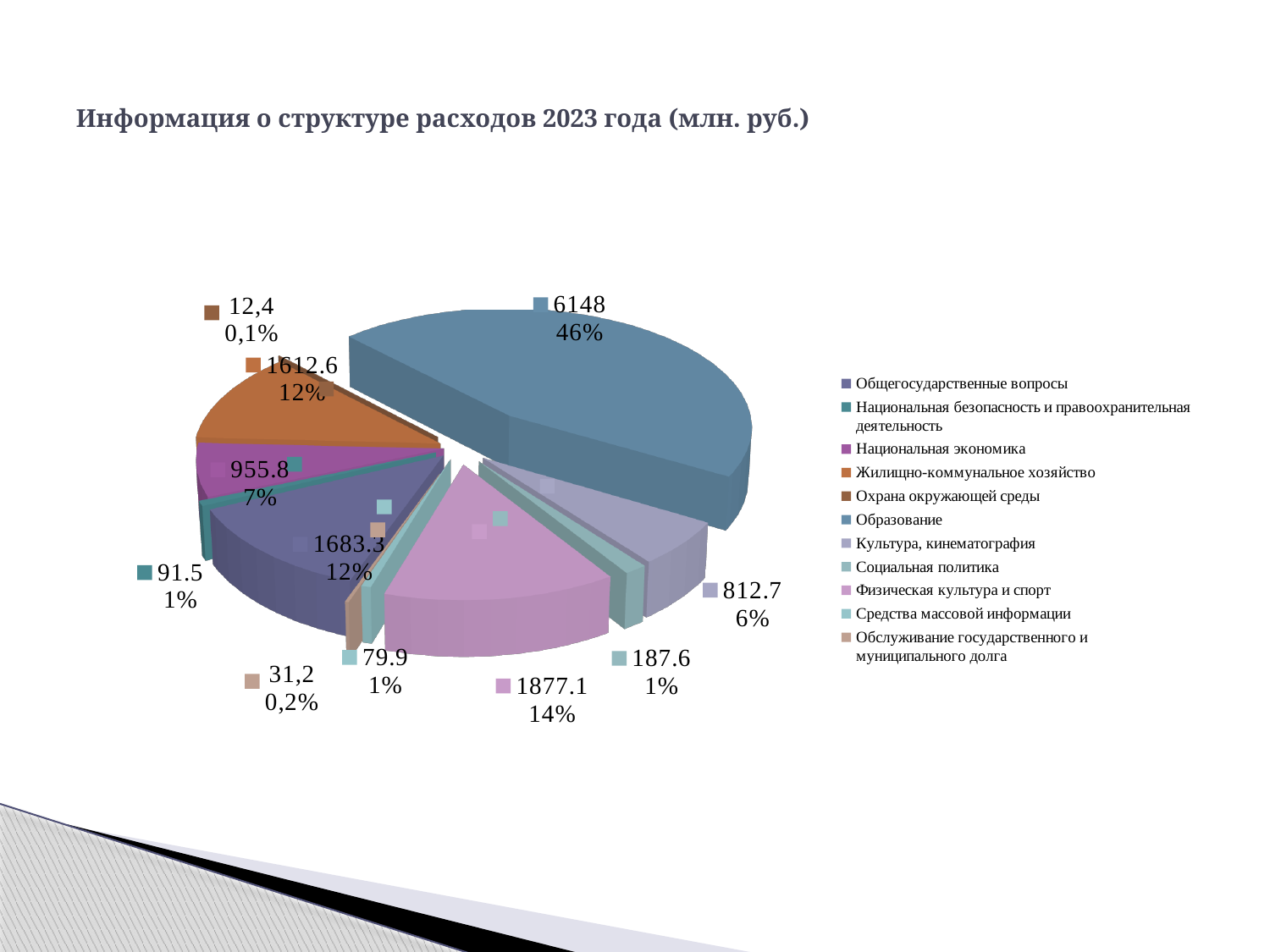
What is the value for Образование? 6148 How many slices does the pie chart have? 11 Which is larger, Физическая культура и спорт or Общегосударственные вопросы? Физическая культура и спорт How many entries does the legend list? 11 What is the title of the chart? Информация о структуре расходов 2023 года (млн. руб.) What share of the pie does Образование take? 46% What is the value for Жилищно-коммунальное хозяйство? 1612.6 What share of the pie does Физическая культура и спорт take? 14% Which category has the smallest slice? Охрана окружающей среды What kind of chart is shown on the slide? Pie chart Which category has the largest slice? Образование What is the difference between the values for Образование and Физическая культура и спорт? 4270.9